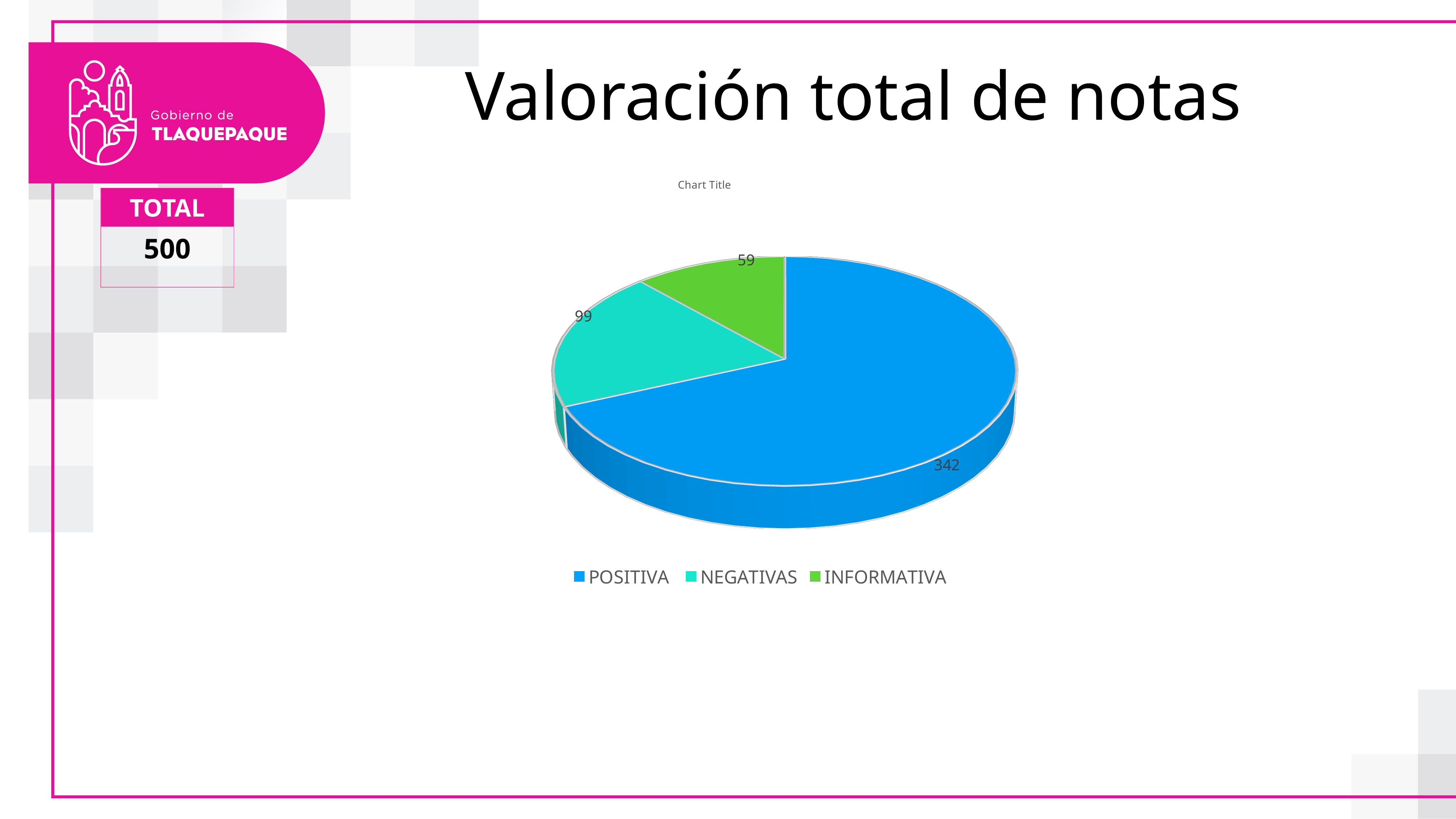
What kind of chart is shown on the slide? Pie chart What is the value for POSITIVA? 342 What is the difference between the NEGATIVAS and INFORMATIVA values? 40 Which is larger, NEGATIVAS or INFORMATIVA? NEGATIVAS What colour is the POSITIVA slice? Blue Which category has the largest slice? POSITIVA Which category has the smallest slice? INFORMATIVA What is the value for NEGATIVAS? 99 What is the difference between the POSITIVA and NEGATIVAS values? 243 What is the total of all three slices? 500 What is the value for INFORMATIVA? 59 How many slices does the pie chart have? 3